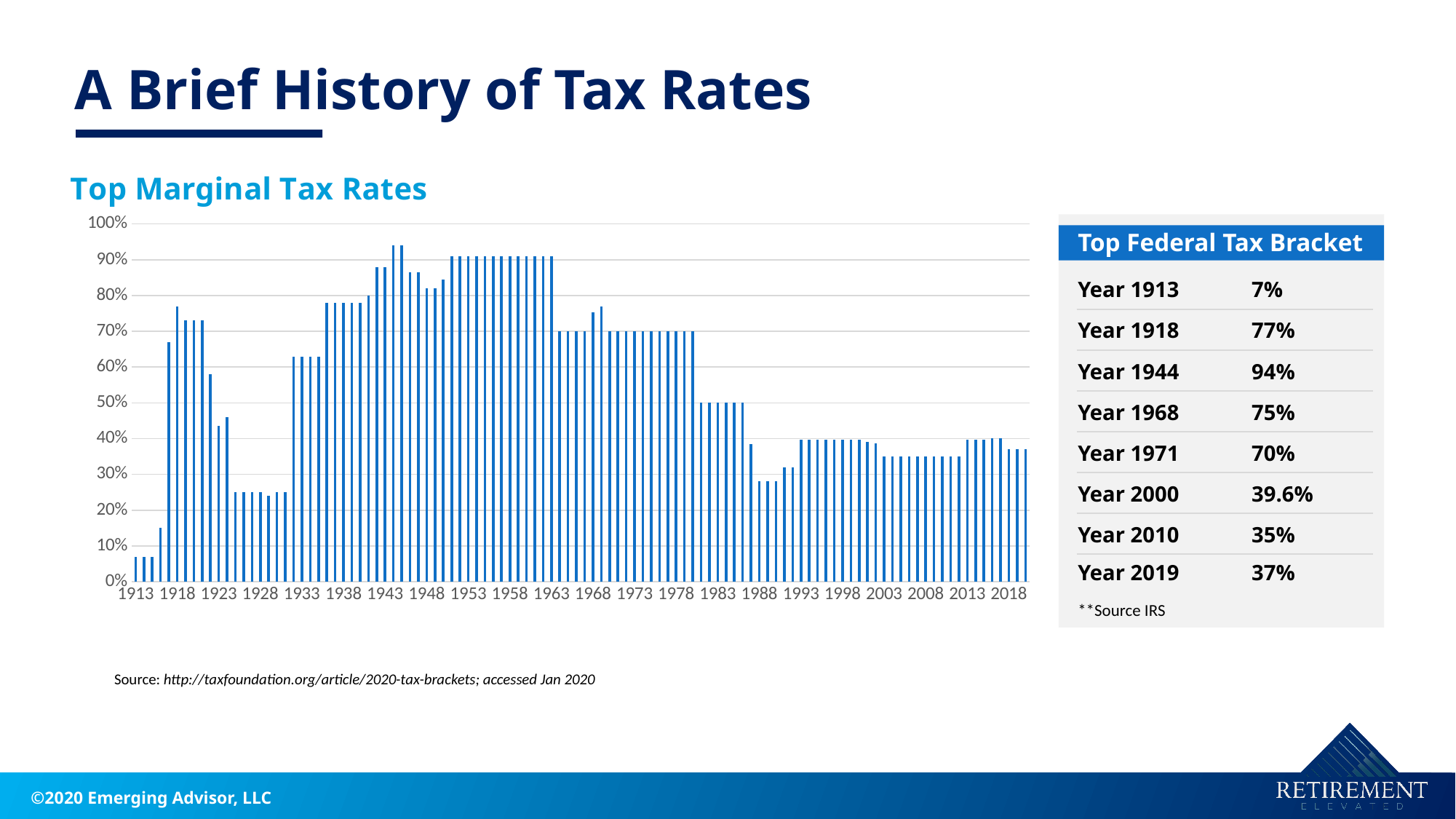
Using the table values, how many percentage points higher was the top rate in 2019 than in 2010? 2 According to the Top Federal Tax Bracket table, what was the top rate in 1944? 94% In the chart, which year has the higher top marginal tax rate, 1950 or 1990? 1950 What is the title of the chart on the slide? Top Marginal Tax Rates In the chart, is the top marginal tax rate for 1928 greater or less than 30%? less In the chart, do the top marginal tax rates rise or fall between 1981 and 1990? fall What is the lowest top marginal tax rate shown on the slide (the rate for 1913)? 7% In the chart, is the top marginal tax rate for 1985 greater or less than 40%? greater What kind of chart is shown under the heading 'Top Marginal Tax Rates'? bar chart Using the table values, how many percentage points higher was the top rate in 1944 than in 1913? 87 What is the highest value shown on the chart's vertical axis? 100% According to the Top Federal Tax Bracket table, what was the top rate in 2000? 39.6%